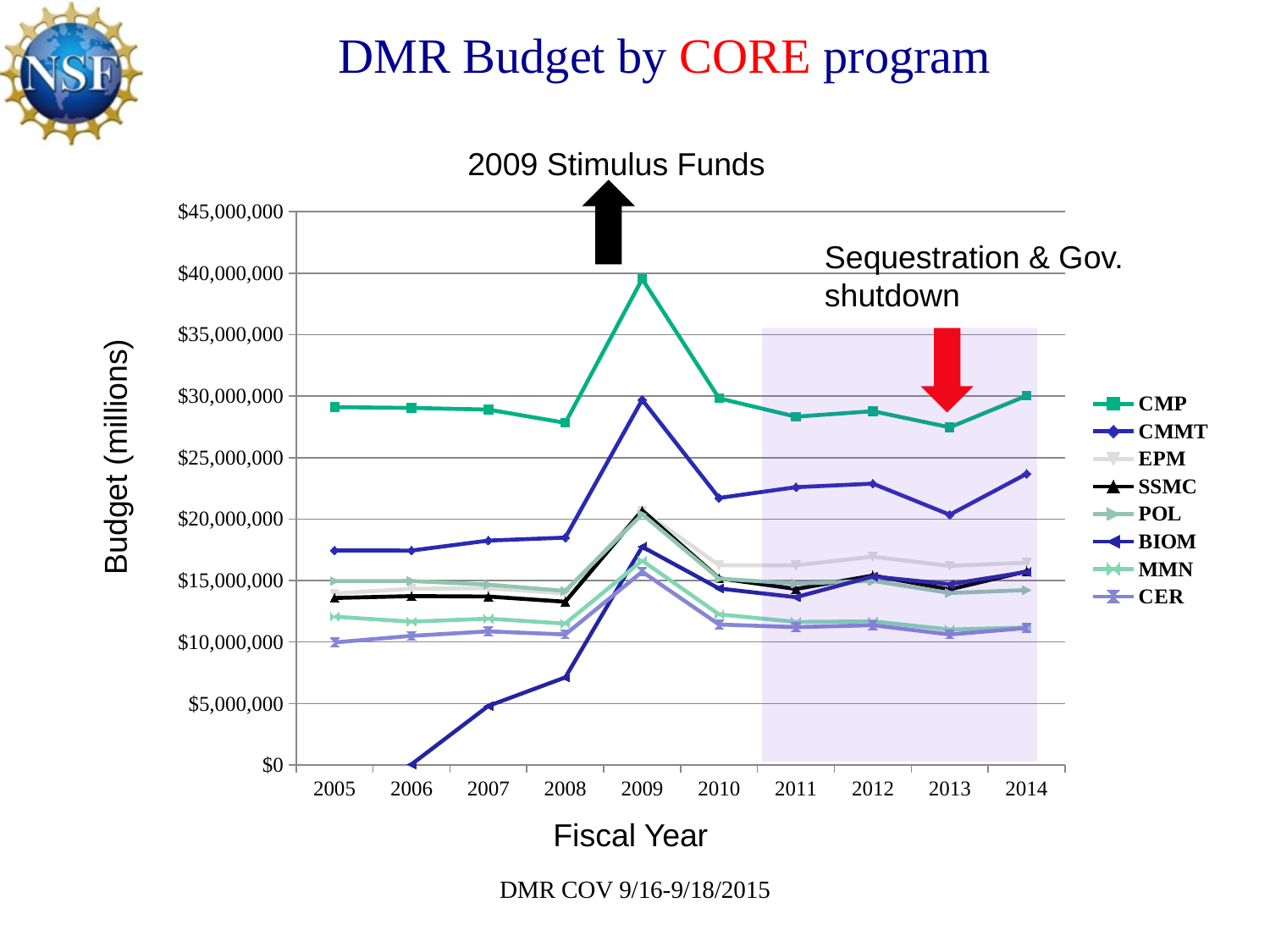
Is the SSMC value for 2008 greater or less than $15,000,000? less What is the title of the chart? DMR Budget by CORE program Is the CMP value for 2013 greater or less than $30,000,000? less What kind of chart is shown on the slide? line chart Which is larger in 2014, the CMP budget or the CMMT budget? CMP How many fiscal years are plotted on the x axis? 10 Which program has the highest budget in 2009? CMP How many series does the legend list? 8 Does the BIOM budget rise or fall from 2006 to 2009? rise Which program has the lowest budget in 2006? BIOM Is the CMP value for 2009 greater or less than $35,000,000? greater